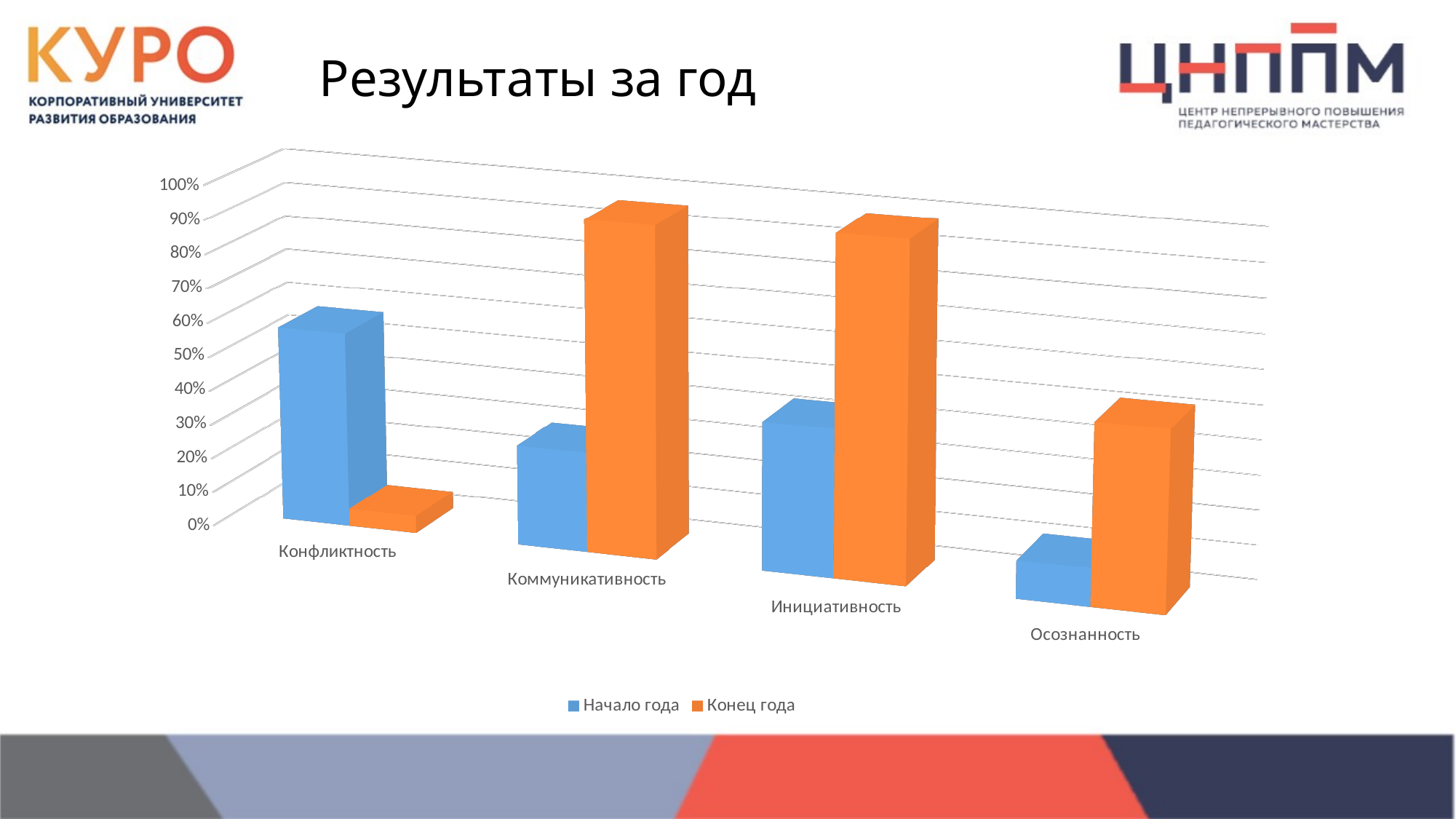
Which category has the lowest value for the Начало года series? Осознанность Is the Конец года value for Конфликтность greater or less than 20%? less For Коммуникативность, which series has the larger value, Начало года or Конец года? Конец года What are the two series named in the chart legend? Начало года, Конец года What is the title of the slide containing the chart? Результаты за год How many series does the chart legend list? 2 For Конфликтность, which series has the larger value, Начало года or Конец года? Начало года Which category has the lowest value for the Конец года series? Конфликтность Which category has the highest value for the Начало года series? Конфликтность How many categories are shown on the x axis of the chart? 4 What kind of chart is shown on the slide? Bar chart Is the Конец года value for Инициативность greater or less than 70%? greater